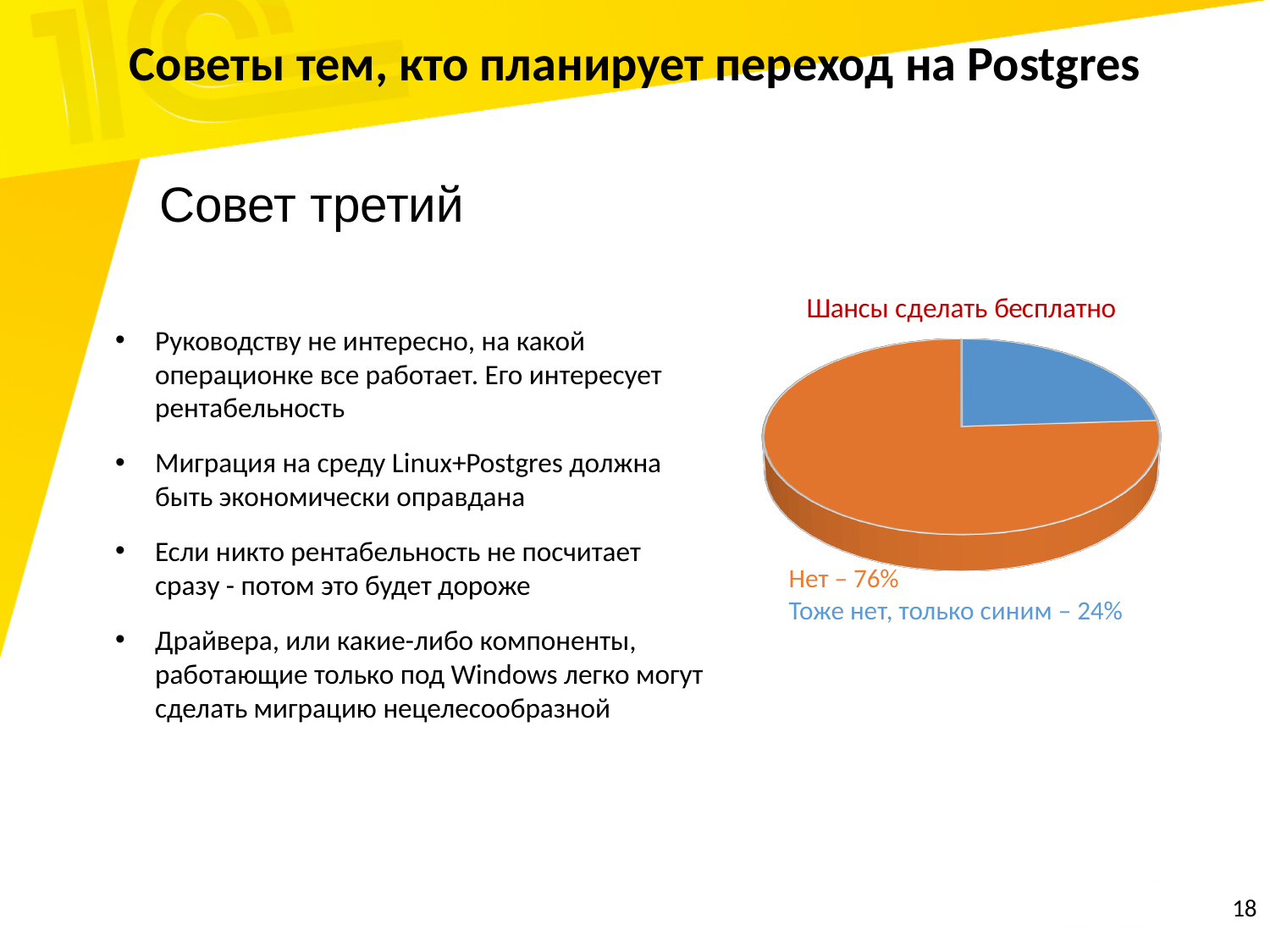
Which is larger: the "Нет" slice or the "Тоже нет, только синим" slice? Нет Is the share of the "Нет" slice greater or less than 50%? greater Which slice of the pie chart is the smallest? Тоже нет, только синим Which slice of the pie chart is the largest? Нет What is the difference in percentage points between the "Нет" slice and the "Тоже нет, только синим" slice? 52 Is the share of the "Тоже нет, только синим" slice greater or less than 50%? less What colour is the "Нет" slice in the pie chart? Orange What share of the pie does the slice "Тоже нет, только синим" take? 24% How many slices does the pie chart have? 2 What is the title of the pie chart? Шансы сделать бесплатно What share of the pie does the slice "Нет" take? 76% What kind of chart is shown on the slide? Pie chart